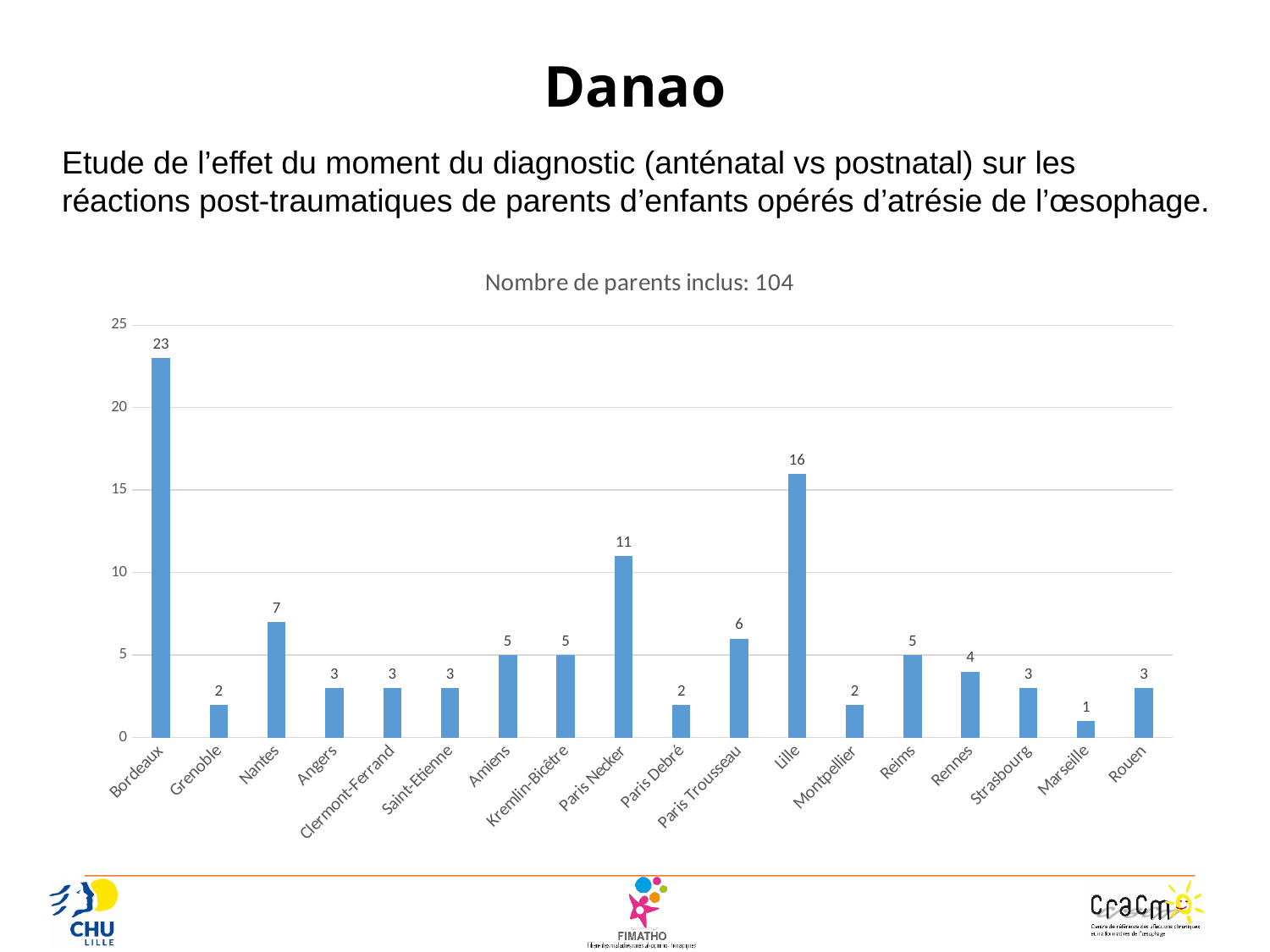
Which is larger, the value for Nantes or the value for Paris Trousseau? Nantes What is the value for Lille? 16 Is the value for Paris Necker greater or less than 10? greater Which category has the highest value? Bordeaux What is the difference between the values for Bordeaux and Lille? 7 How many categories are shown on the x axis? 18 What is the title of the chart? Nombre de parents inclus: 104 What kind of chart is shown on the slide? bar chart What is the value for Paris Necker? 11 Which category has the lowest value? Marseille What is the value for Bordeaux? 23 What is the value for Rennes? 4